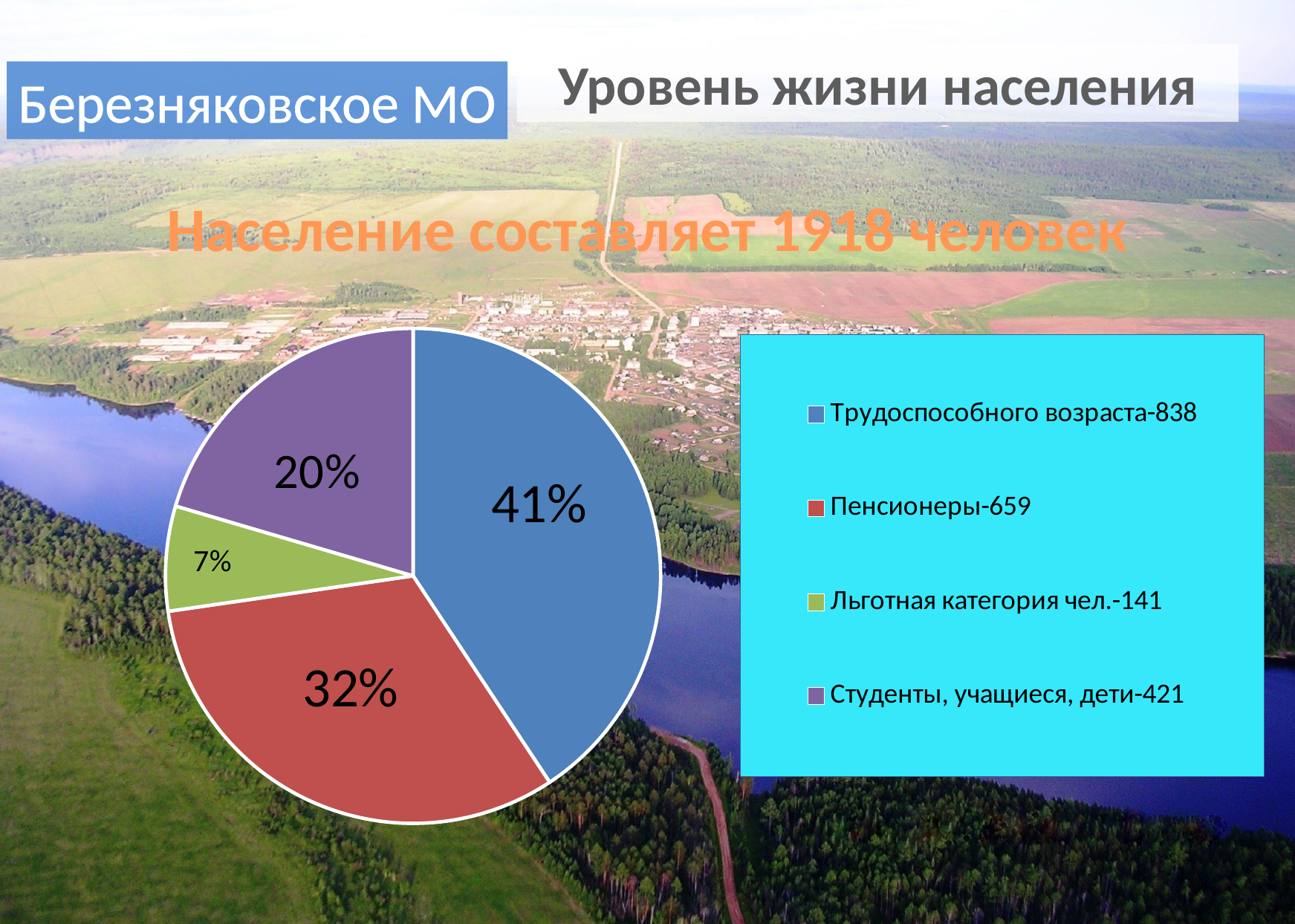
Which category has the largest slice of the pie? Трудоспособного возраста What percentage share does the slice for Пенсионеры show? 32% Which slice is larger: Пенсионеры or Студенты, учащиеся, дети? Пенсионеры Which category has the smallest slice of the pie? Льготная категория What percentage share does the slice for Студенты, учащиеся, дети show? 20% What is the difference in percentage points between the Трудоспособного возраста slice and the Пенсионеры slice? 9% What percentage share does the slice for Трудоспособного возраста show? 41% According to the legend, how many people are in the Пенсионеры category? 659 What kind of chart is shown on the slide? pie chart What colour is the slice for Студенты, учащиеся, дети? purple How many categories does the pie chart show? 4